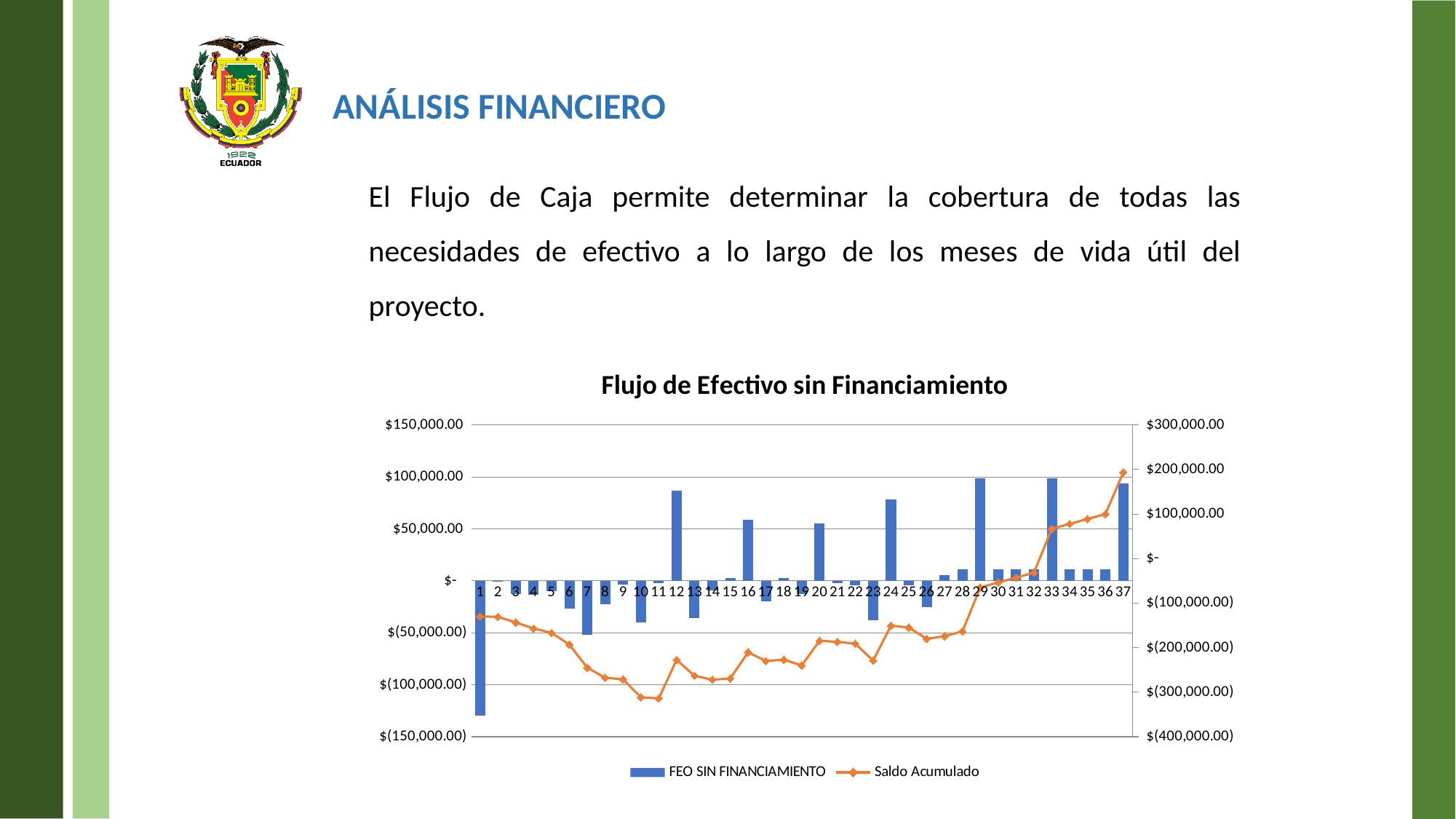
Is the Saldo Acumulado value for period 10 greater or less than $(200,000.00) on the right axis? less Does the Saldo Acumulado line rise or fall from period 28 to period 37? It rises Is the FEO SIN FINANCIAMIENTO value for period 12 greater or less than $50,000.00? greater How many series does the legend list? 2 In which period is the FEO SIN FINANCIAMIENTO bar lowest? 1 How many periods (months) are plotted along the x axis? 37 What is the title of the chart? Flujo de Efectivo sin Financiamiento Which series is drawn as a line with markers? Saldo Acumulado Is the Saldo Acumulado value for period 37 greater or less than $100,000.00 on the right axis? greater Which has the larger FEO SIN FINANCIAMIENTO value, period 12 or period 16? Period 12 What kind of chart is shown on the slide? A combined bar and line chart